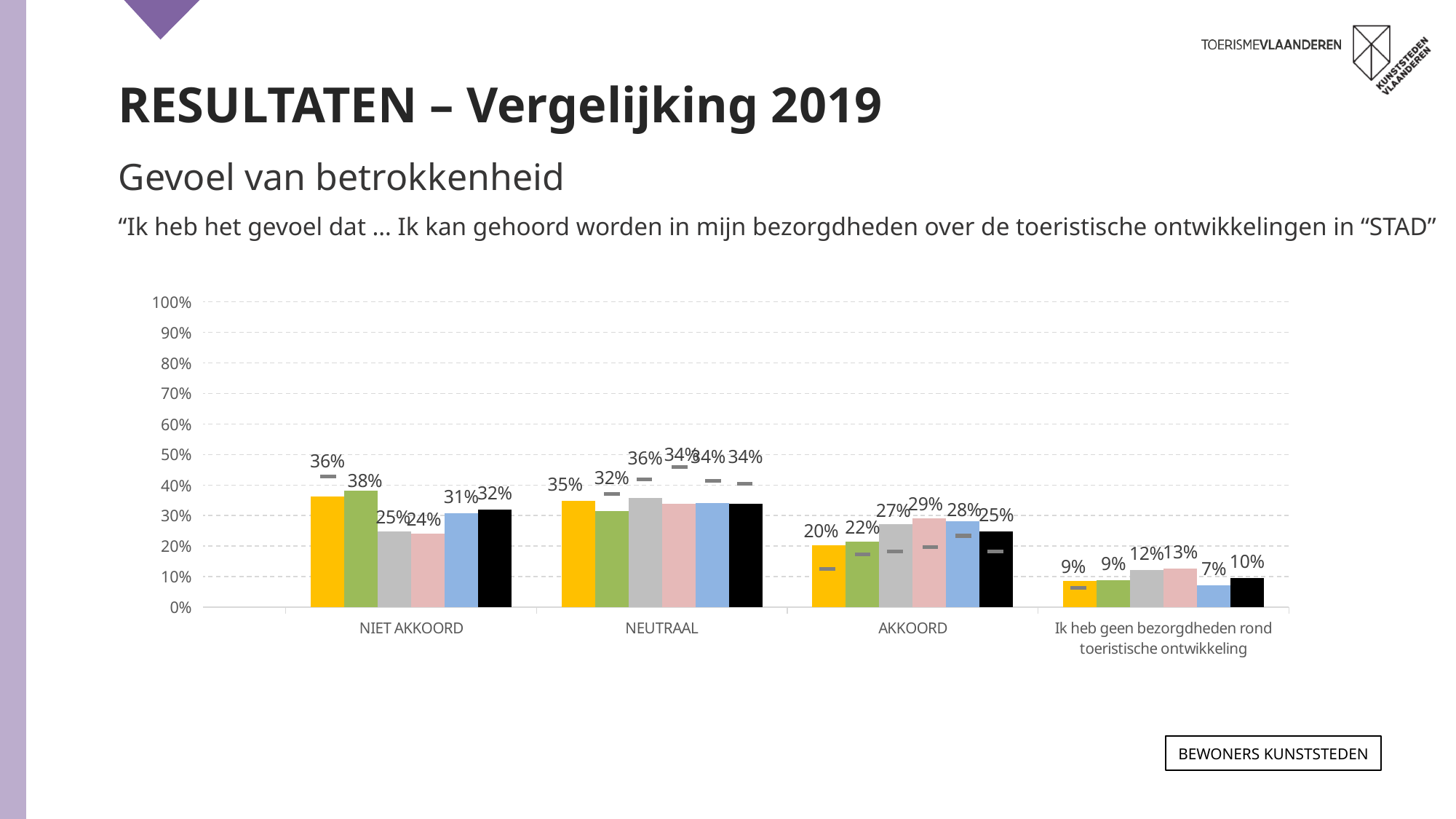
Which is larger for AKKOORD: the yellow bar or the black bar? the black bar (25%) What is the value of the grey bar for NEUTRAAL? 36% What is the value of the green bar for NIET AKKOORD? 38% Which bar is the highest in the NIET AKKOORD group? the green bar (38%) Which bar is the lowest in the 'Ik heb geen bezorgdheden rond toeristische ontwikkeling' group? the blue bar (7%) What is the value of the blue bar for 'Ik heb geen bezorgdheden rond toeristische ontwikkeling'? 7% What is the difference between the green bar and the pink bar for NIET AKKOORD? 14% What is the value of the pink bar for AKKOORD? 29% How many bars are plotted in each category group? 6 What is the value of the yellow bar for NIET AKKOORD? 36% How many categories are shown on the x axis of the chart? 4 What kind of chart is shown on the slide? bar chart